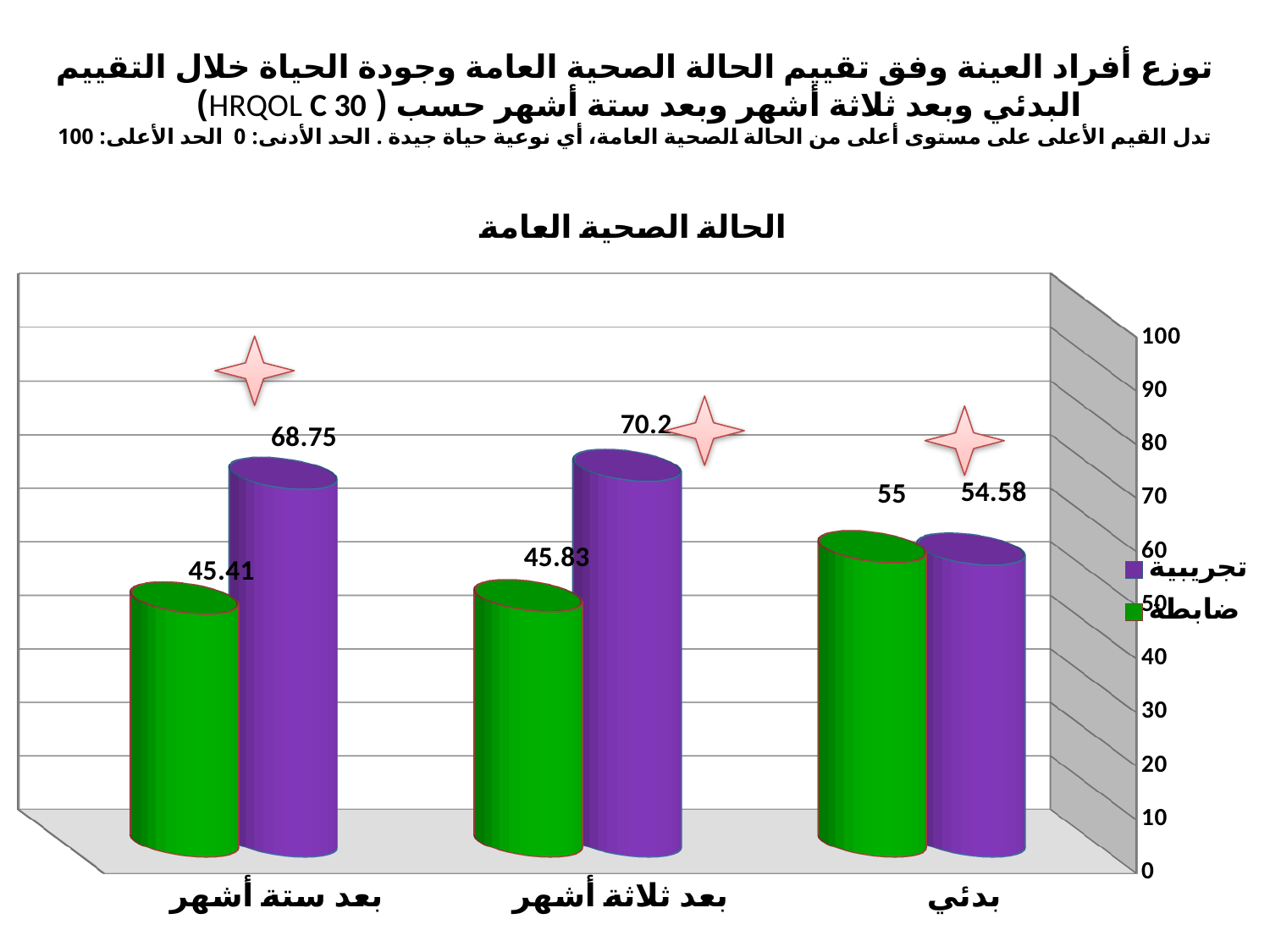
What is the value for the ضابطة series at بدئي? 55 What is the value for the ضابطة series at بعد ستة أشهر? 45.41 How many categories are shown on the x axis? 3 What is the value for the تجريبية series at بعد ستة أشهر? 68.75 At بعد ستة أشهر, which series has the larger value, تجريبية or ضابطة? تجريبية What type of chart is shown? bar chart At which category does the تجريبية series reach its highest value? بعد ثلاثة أشهر What is the value for the تجريبية series at بعد ثلاثة أشهر? 70.2 What is the value for the تجريبية series at بدئي? 54.58 At which category does the ضابطة series have its lowest value? بعد ستة أشهر What is the difference between the تجريبية and ضابطة values at بعد ثلاثة أشهر? 24.37 How many series does the legend list? 2